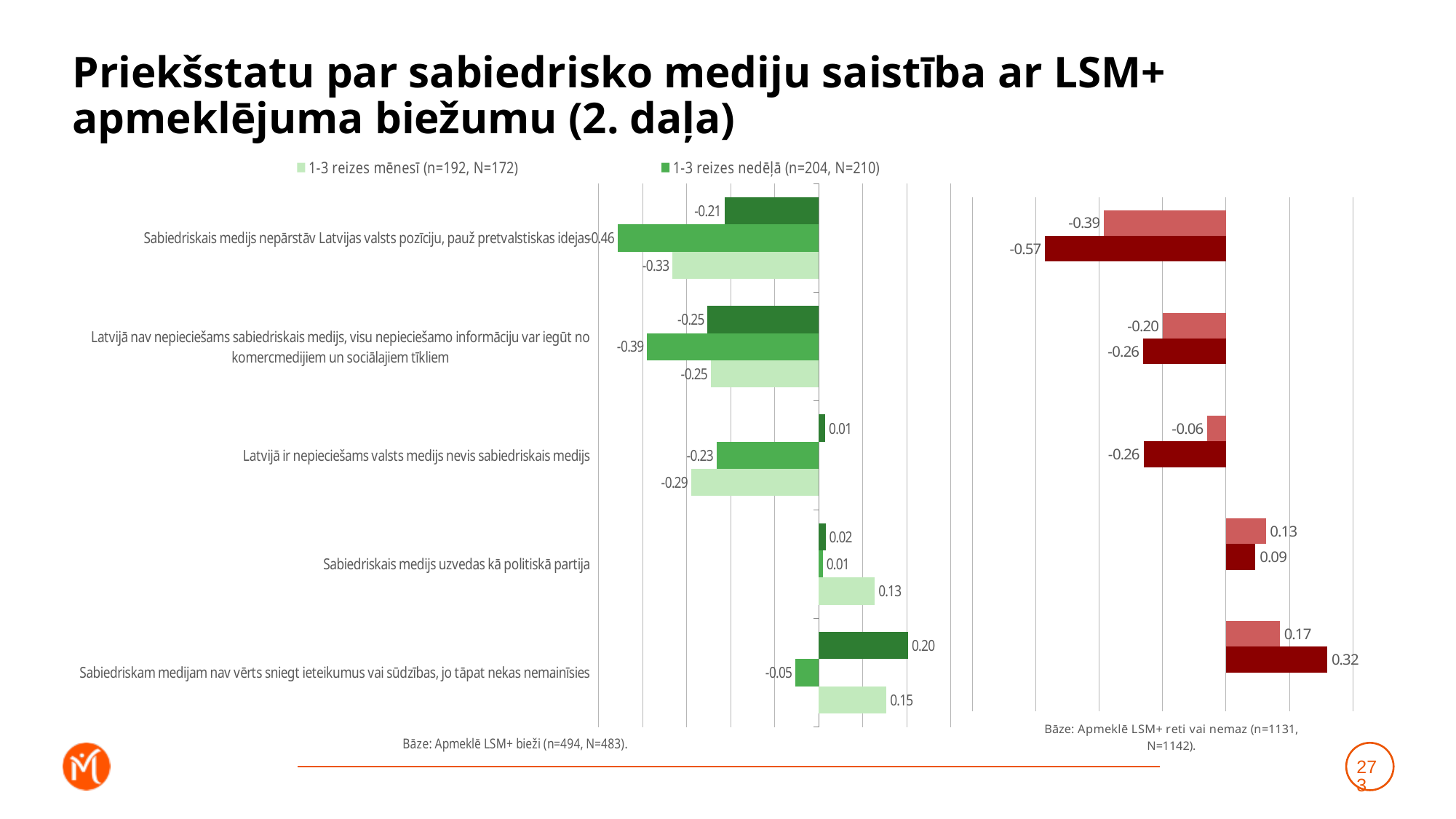
How many statements (categories) are listed on the left chart? 5 In the left chart, which statement has the highest '1-3 reizes mēnesī' value? Sabiedriskam medijam nav vērts sniegt ieteikumus vai sūdzības, jo tāpat nekas nemainīsies In the left chart, what is the value for '1-3 reizes nedēļā' for the statement 'Sabiedriskais medijs nepārstāv Latvijas valsts pozīciju, pauž pretvalstiskas idejas'? -0.46 In the right chart (Bāze: Apmeklē LSM+ reti vai nemaz), what is the light red value for the statement 'Sabiedriskam medijam nav vērts sniegt ieteikumus vai sūdzības, jo tāpat nekas nemainīsies'? 0.17 In the left chart, what is the value for '1-3 reizes mēnesī' for the statement 'Sabiedriskais medijs uzvedas kā politiskā partija'? 0.13 In the right chart, which statement has the lowest dark red value? Sabiedriskais medijs nepārstāv Latvijas valsts pozīciju, pauž pretvalstiskas idejas In the left chart, what is the value for '1-3 reizes nedēļā' for the statement 'Sabiedriskam medijam nav vērts sniegt ieteikumus vai sūdzības, jo tāpat nekas nemainīsies'? -0.05 What type of chart is used on this slide? bar chart In the right chart (Bāze: Apmeklē LSM+ reti vai nemaz), what is the dark red value for the statement 'Sabiedriskais medijs nepārstāv Latvijas valsts pozīciju, pauž pretvalstiskas idejas'? -0.57 In the right chart, for the statement 'Sabiedriskais medijs uzvedas kā politiskā partija', which is larger: the light red value or the dark red value? light red (0.13) In the left chart, what is the value for '1-3 reizes mēnesī' for the statement 'Latvijā ir nepieciešams valsts medijs nevis sabiedriskais medijs'? -0.29 In the left chart, for the statement 'Sabiedriskais medijs nepārstāv Latvijas valsts pozīciju, pauž pretvalstiskas idejas', what is the difference between the '1-3 reizes mēnesī' value and the '1-3 reizes nedēļā' value? 0.13